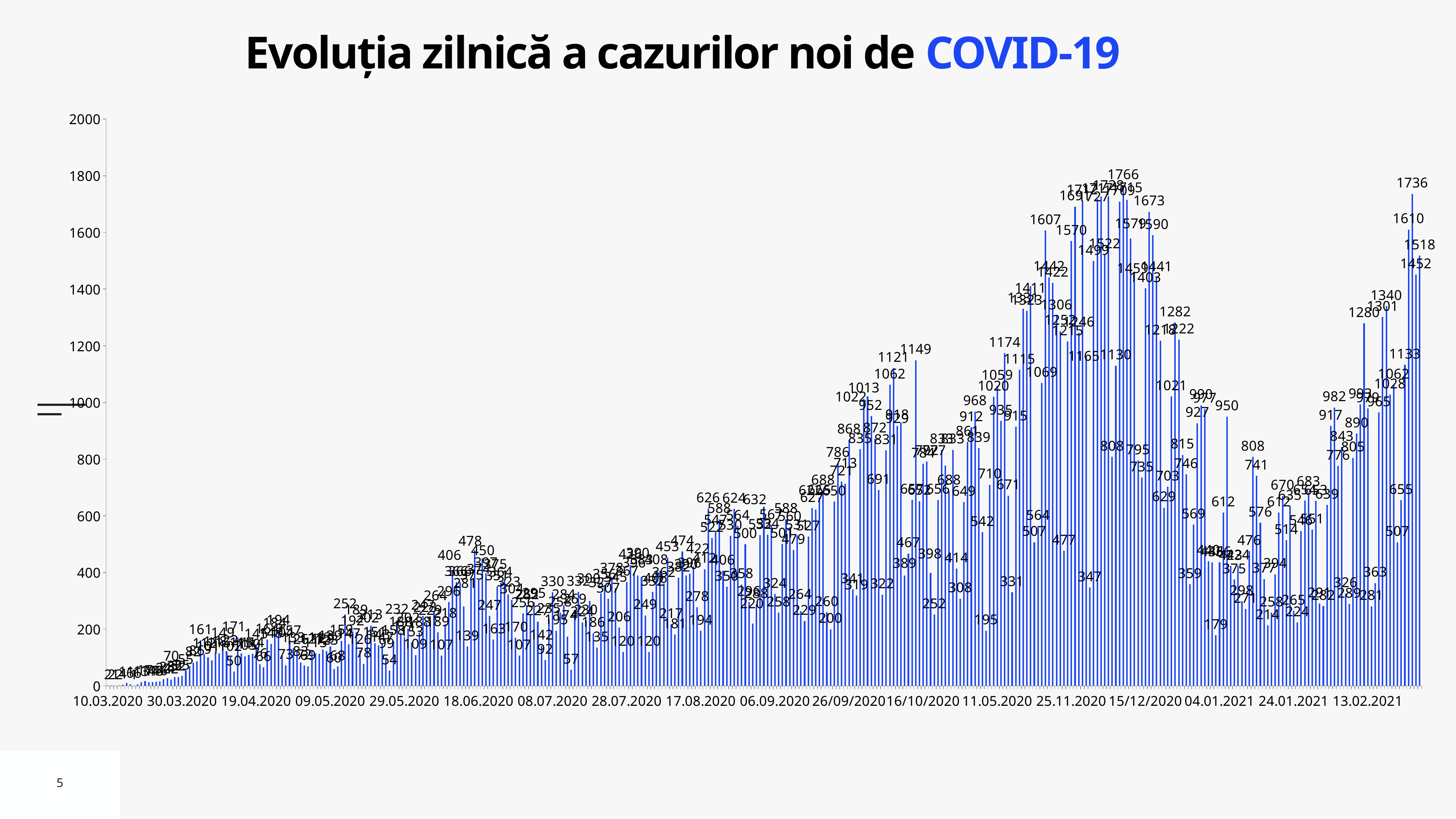
How many date labels are shown on the horizontal axis? 18 Is the highest bar on the chart greater or less than 1800? less Is the peak in December 2020 higher or lower than the peak in February 2021? higher What kind of chart is shown on the slide? bar chart What is the title of the chart? Evoluția zilnică a cazurilor noi de COVID-19 What is the maximum value shown on the vertical axis? 2000 What is the highest value labeled in the February 2021 part of the chart? 1736 What is the last date label on the horizontal axis? 13.02.2021 What is the highest daily value labeled on the chart? 1766 What is the difference between the overall peak value (1766) and the February 2021 peak value (1736)? 30 What is the first date label on the horizontal axis? 10.03.2020 Do the daily values generally rise or fall from March 2020 to mid-June 2020? rise